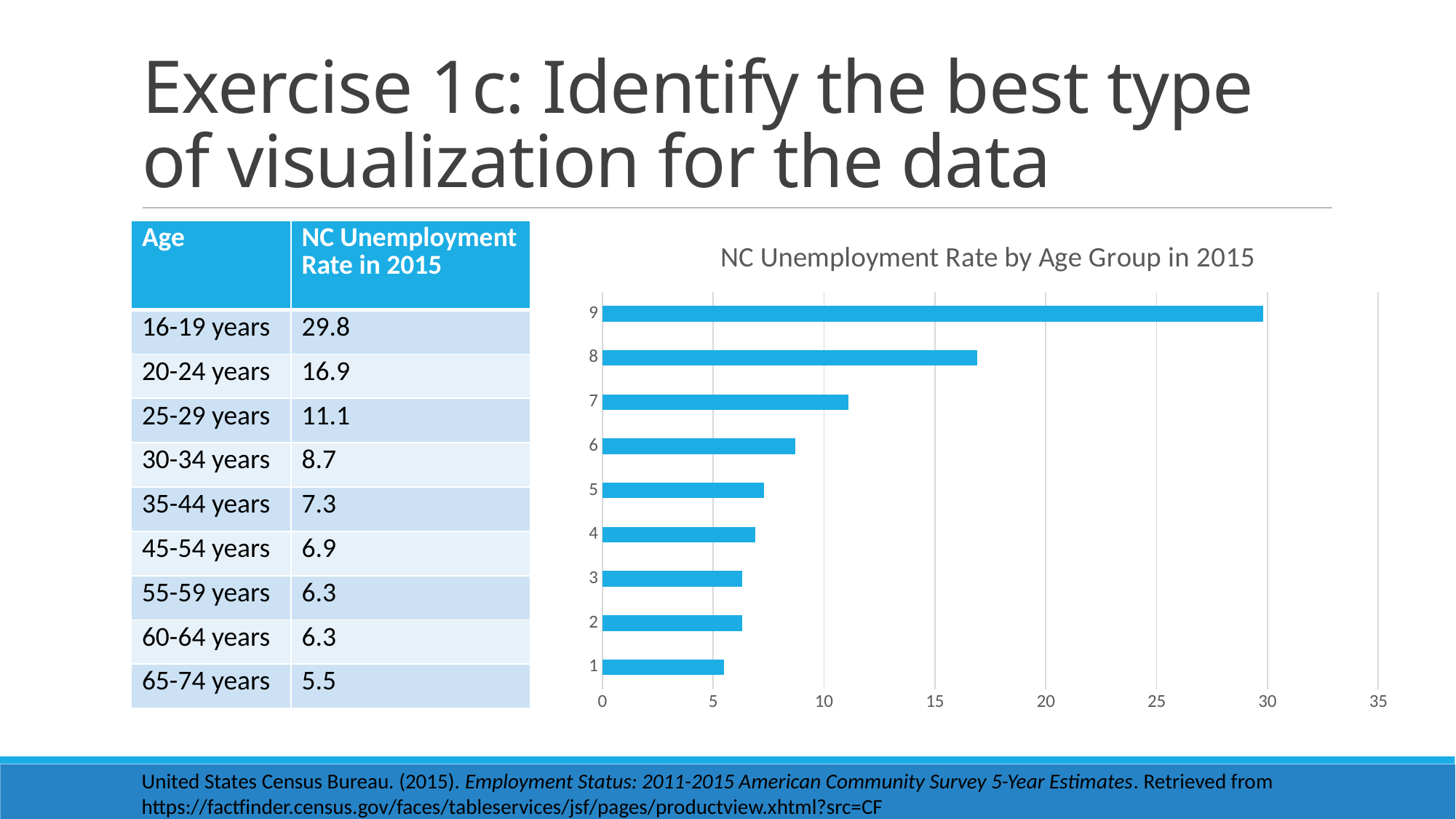
Which category has the shortest bar in the chart? 1 Which category has the longest bar in the chart? 9 Is the value for category 5 greater or less than 5? greater What is the title of the chart? NC Unemployment Rate by Age Group in 2015 Is the value for category 8 greater or less than 15? greater What type of chart is shown on the slide? bar chart How many bars are plotted in the chart? 9 Is the value for category 6 greater or less than 10? less What is the highest tick value shown on the horizontal axis of the chart? 35 Which has the larger value, category 8 or category 7? 8 Do the bars get longer or shorter going from category 1 up to category 9? longer